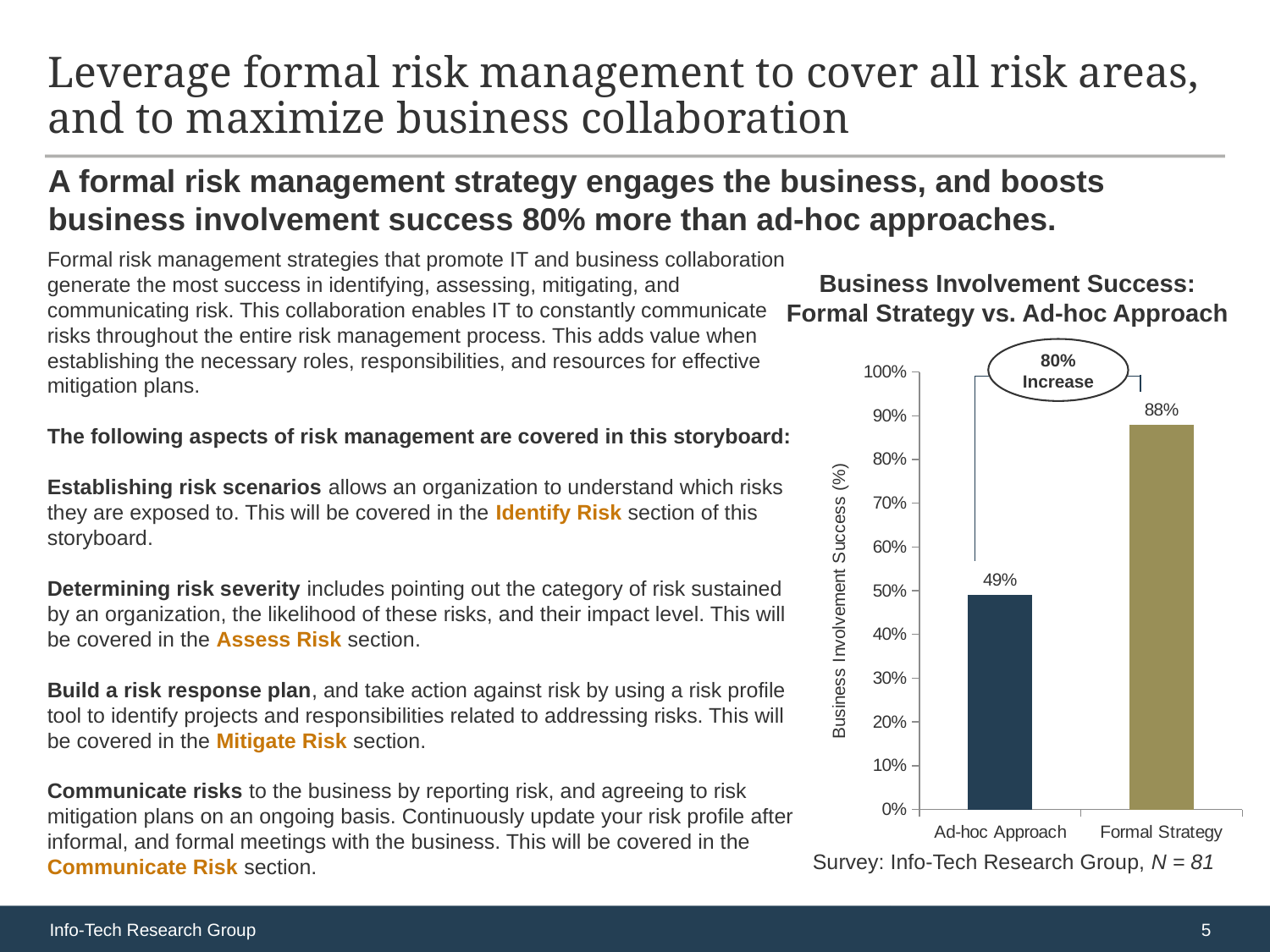
What is the value for Ad-hoc Approach? 49% What is the difference between the values for Formal Strategy and Ad-hoc Approach? 39% What kind of chart is shown on the slide? bar chart What is the title of the chart? Business Involvement Success: Formal Strategy vs. Ad-hoc Approach How many categories are shown on the x axis? 2 Which category has the lowest value? Ad-hoc Approach Is the value for Formal Strategy greater or less than 80%? greater Which category has the highest value? Formal Strategy What is the value for Formal Strategy? 88% Which is larger, the value for Ad-hoc Approach or the value for Formal Strategy? Formal Strategy What is the label on the y axis of the chart? Business Involvement Success (%) Is the value for Ad-hoc Approach greater or less than 60%? less